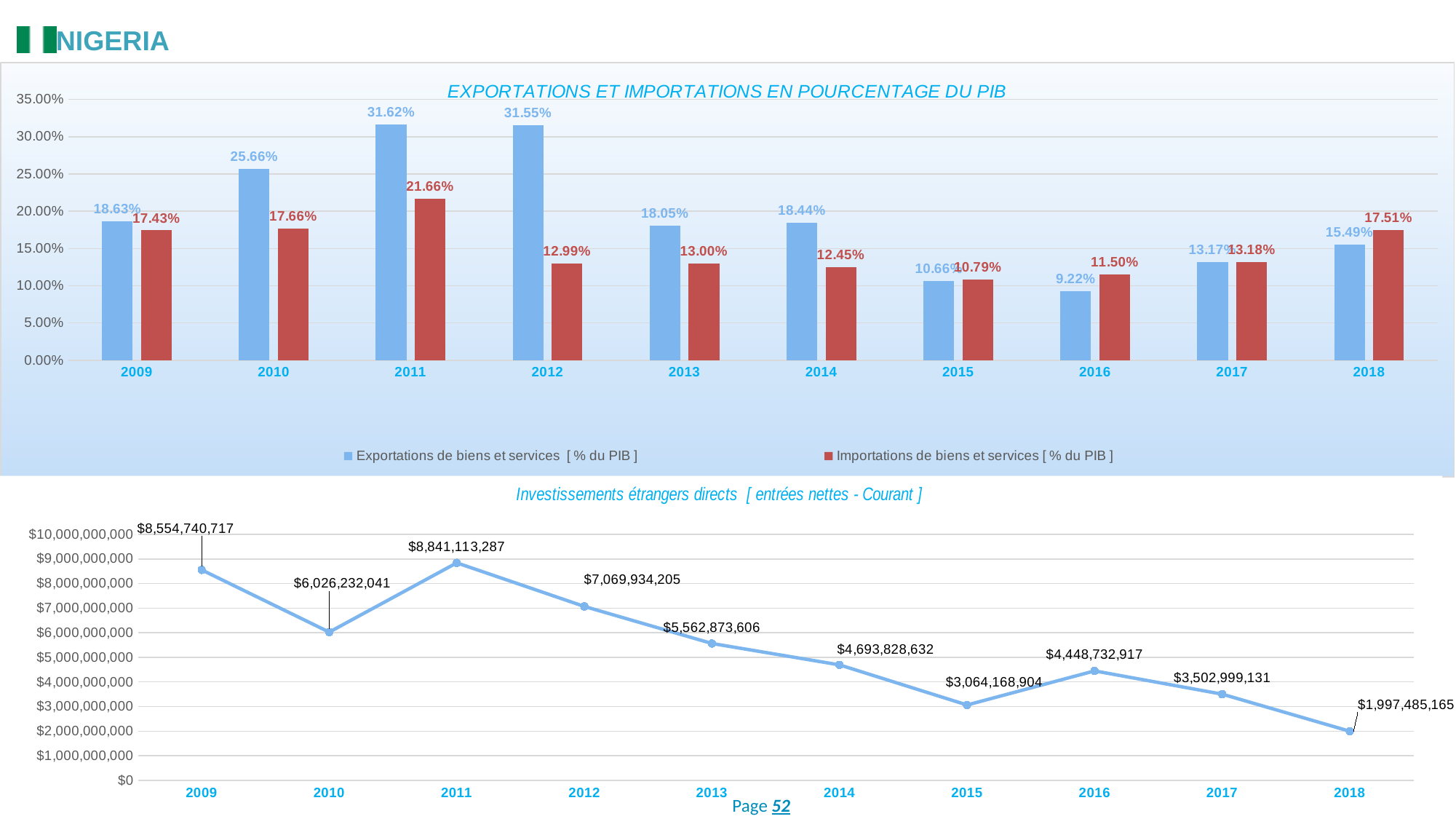
What kind of chart is 'EXPORTATIONS ET IMPORTATIONS EN POURCENTAGE DU PIB'? Bar chart In the chart 'Investissements étrangers directs', what is the difference between the 2009 and 2018 values? $6,557,255,552 In the chart 'EXPORTATIONS ET IMPORTATIONS EN POURCENTAGE DU PIB', what is the difference between exports and imports in 2011? 9.96% How many years are plotted in the chart 'Investissements étrangers directs'? 10 How many series does the legend of the chart 'EXPORTATIONS ET IMPORTATIONS EN POURCENTAGE DU PIB' list? 2 In the chart 'EXPORTATIONS ET IMPORTATIONS EN POURCENTAGE DU PIB', what is the value of imports of goods and services in 2018? 17.51% In the chart 'EXPORTATIONS ET IMPORTATIONS EN POURCENTAGE DU PIB', which is larger in 2016, exports or imports? Imports In the chart 'Investissements étrangers directs', which year has the highest value? 2011 In the chart 'EXPORTATIONS ET IMPORTATIONS EN POURCENTAGE DU PIB', what is the value of exports of goods and services in 2011? 31.62% In the chart 'Investissements étrangers directs', what is the value for 2015? $3,064,168,904 In the chart 'EXPORTATIONS ET IMPORTATIONS EN POURCENTAGE DU PIB', which year has the lowest export value? 2016 In the chart 'EXPORTATIONS ET IMPORTATIONS EN POURCENTAGE DU PIB', which year has the highest import value? 2011